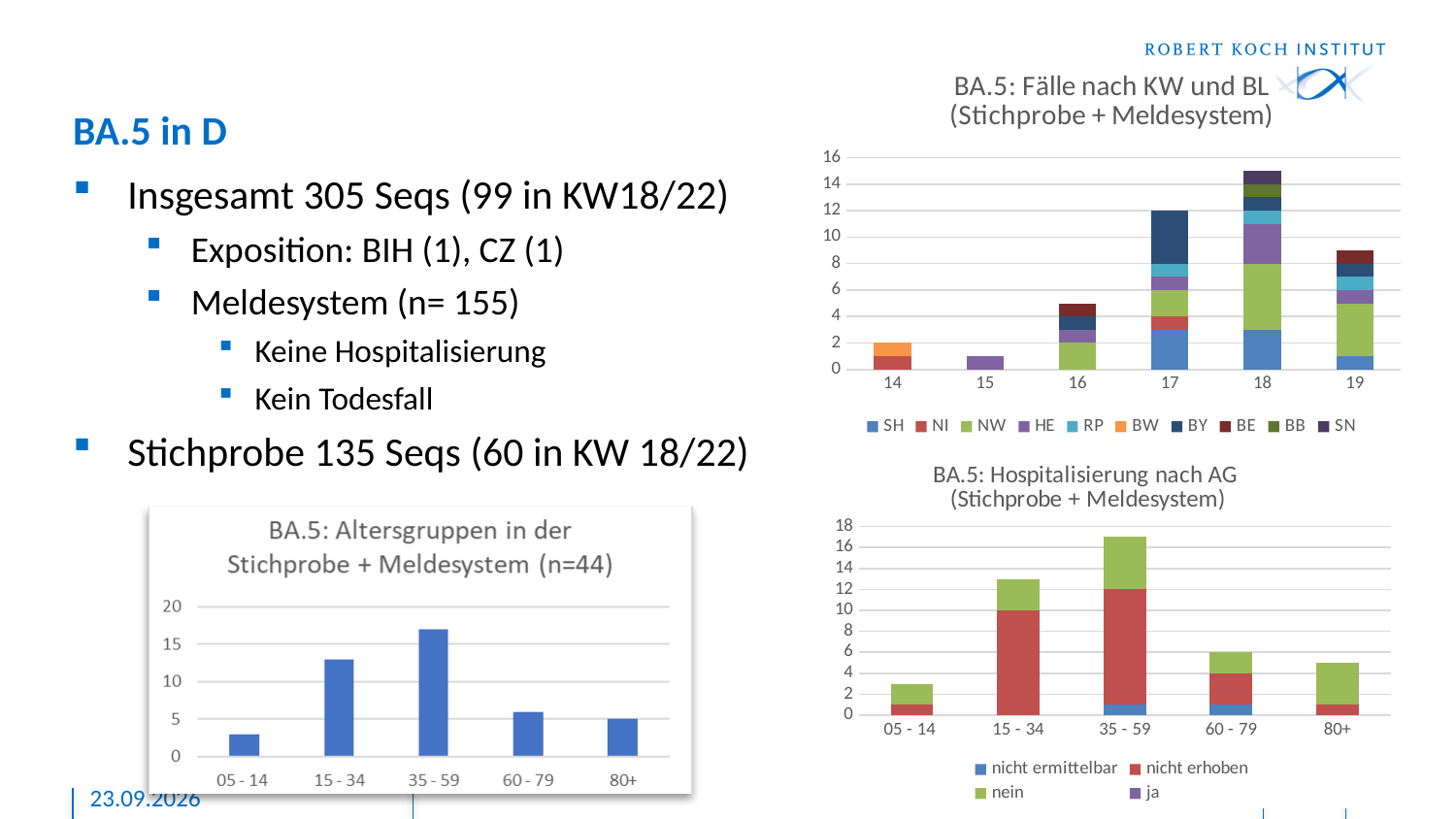
How many series does the legend of the chart "BA.5: Fälle nach KW und BL (Stichprobe + Meldesystem)" list? 10 In the chart "BA.5: Altersgruppen in der Stichprobe + Meldesystem (n=44)", which is larger, the value for 15 - 34 or the value for 60 - 79? 15 - 34 In the chart "BA.5: Altersgruppen in der Stichprobe + Meldesystem (n=44)", how many age groups are shown on the x axis? 5 In the chart "BA.5: Hospitalisierung nach AG (Stichprobe + Meldesystem)", is the total for 35 - 59 greater or less than 14? greater In the chart "BA.5: Altersgruppen in der Stichprobe + Meldesystem (n=44)", which age group has the highest value? 35 - 59 In the chart "BA.5: Hospitalisierung nach AG (Stichprobe + Meldesystem)", which age group has the tallest stacked bar? 35 - 59 In the chart "BA.5: Altersgruppen in der Stichprobe + Meldesystem (n=44)", which age group has the lowest value? 05 - 14 In the chart "BA.5: Altersgruppen in der Stichprobe + Meldesystem (n=44)", is the value for 15 - 34 greater or less than 10? greater In the chart "BA.5: Fälle nach KW und BL (Stichprobe + Meldesystem)", is the total for KW 17 greater or less than 10? greater What kind of chart is "BA.5: Altersgruppen in der Stichprobe + Meldesystem (n=44)"? bar chart How many series does the legend of the chart "BA.5: Hospitalisierung nach AG (Stichprobe + Meldesystem)" list? 4 In the chart "BA.5: Fälle nach KW und BL (Stichprobe + Meldesystem)", which calendar week (KW) has the tallest stacked bar? 18